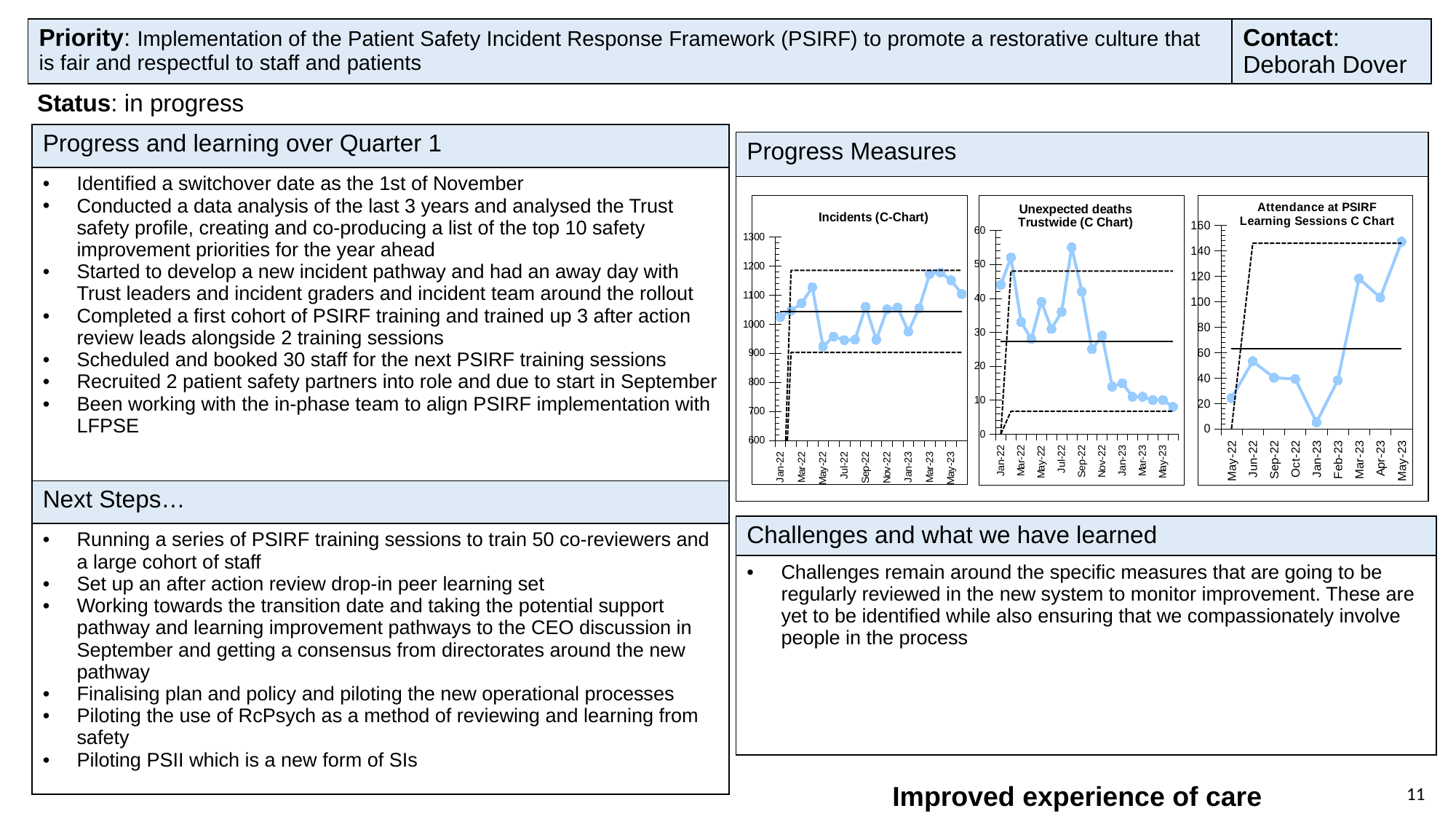
In the Incidents (C-Chart), which is larger, the value for Mar-23 or the value for May-22? Mar-23 In the Attendance at PSIRF Learning Sessions C Chart, which is larger, the value for May-22 or the value for May-23? May-23 What is the title of the rightmost chart in the Progress Measures section? Attendance at PSIRF Learning Sessions C Chart In the Unexpected deaths Trustwide (C Chart), which is larger, the value for Jan-22 or the value for Jan-23? Jan-22 How many charts are shown in the Progress Measures section? 3 What kind of chart is the Incidents (C-Chart)? Line chart In the Unexpected deaths Trustwide (C Chart), is the value for Jan-23 greater or less than 20? less In the Incidents (C-Chart), is the value for May-22 greater or less than 1000? less In the Incidents (C-Chart), is the value for Mar-23 greater or less than 1100? greater In the Unexpected deaths Trustwide (C Chart), do the values generally rise or fall from Jan-22 to the end of the series? Fall